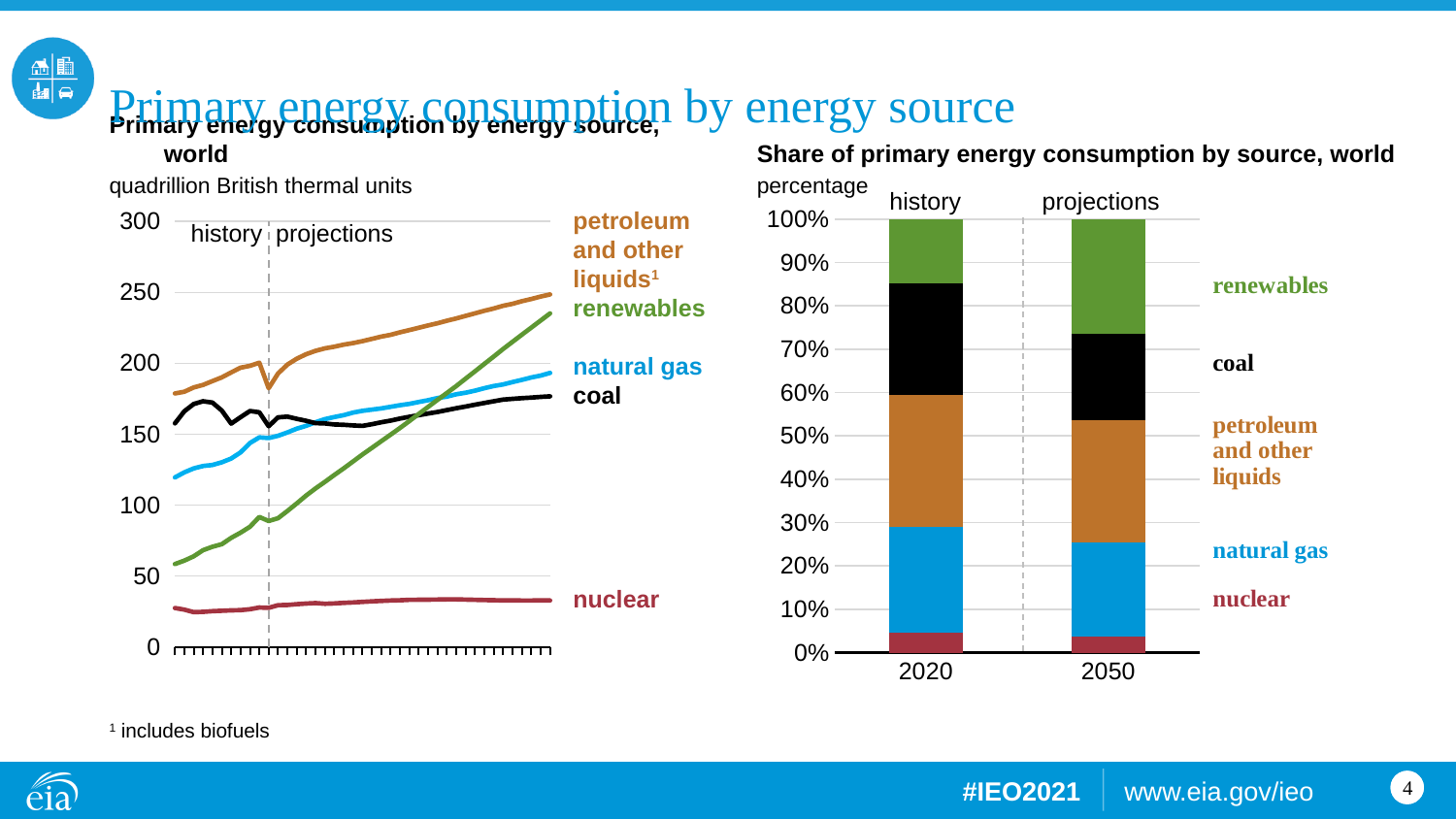
In the left chart, is the value for petroleum and other liquids at the end of the projections greater or less than 200? greater What unit is used on the y axis of the left chart? quadrillion British thermal units In the right chart, is the share of renewables larger in 2020 or in 2050? 2050 In the right chart, is the share of coal larger in 2020 or in 2050? 2020 In the left chart, which energy source has the highest consumption at the end of the projection period? petroleum and other liquids What kind of chart is the right chart, 'Share of primary energy consumption by source, world'? stacked bar chart In the left chart, how many energy source series are plotted? 5 What kind of chart is the left chart, 'Primary energy consumption by energy source, world'? line chart In the left chart, is the value for natural gas at the end of the projections greater or less than 200? less In the right chart, how many years are shown on the x axis? 2 In the left chart, which energy source has the lowest consumption throughout the period? nuclear In the left chart, does renewables consumption rise or fall over the projection period? rise